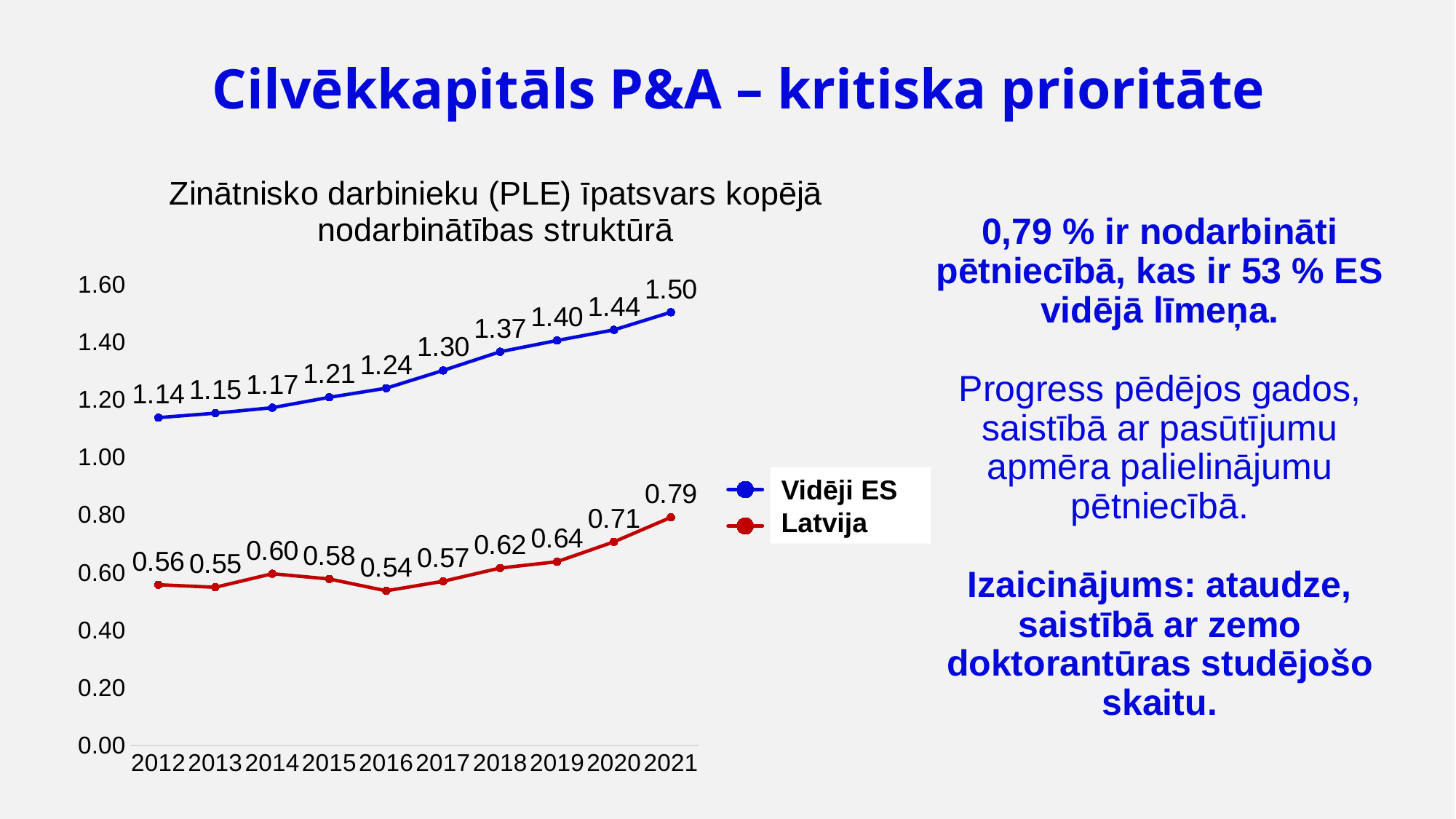
Which series has the larger value in 2018, Vidēji ES or Latvija? Vidēji ES Does the Vidēji ES series rise or fall from 2012 to 2021? Rise What colour is the Latvija line? Red In which year is the Vidēji ES series at its highest? 2021 What is the value for Latvija in 2012? 0.56 How many series does the legend list? 2 In which year is the Latvija series at its lowest? 2016 How many years are shown on the x axis? 10 What is the value for Latvija in 2016? 0.54 What kind of chart is shown on the slide? Line chart What is the value for Vidēji ES in 2021? 1.50 What is the difference between Vidēji ES and Latvija in 2021? 0.71